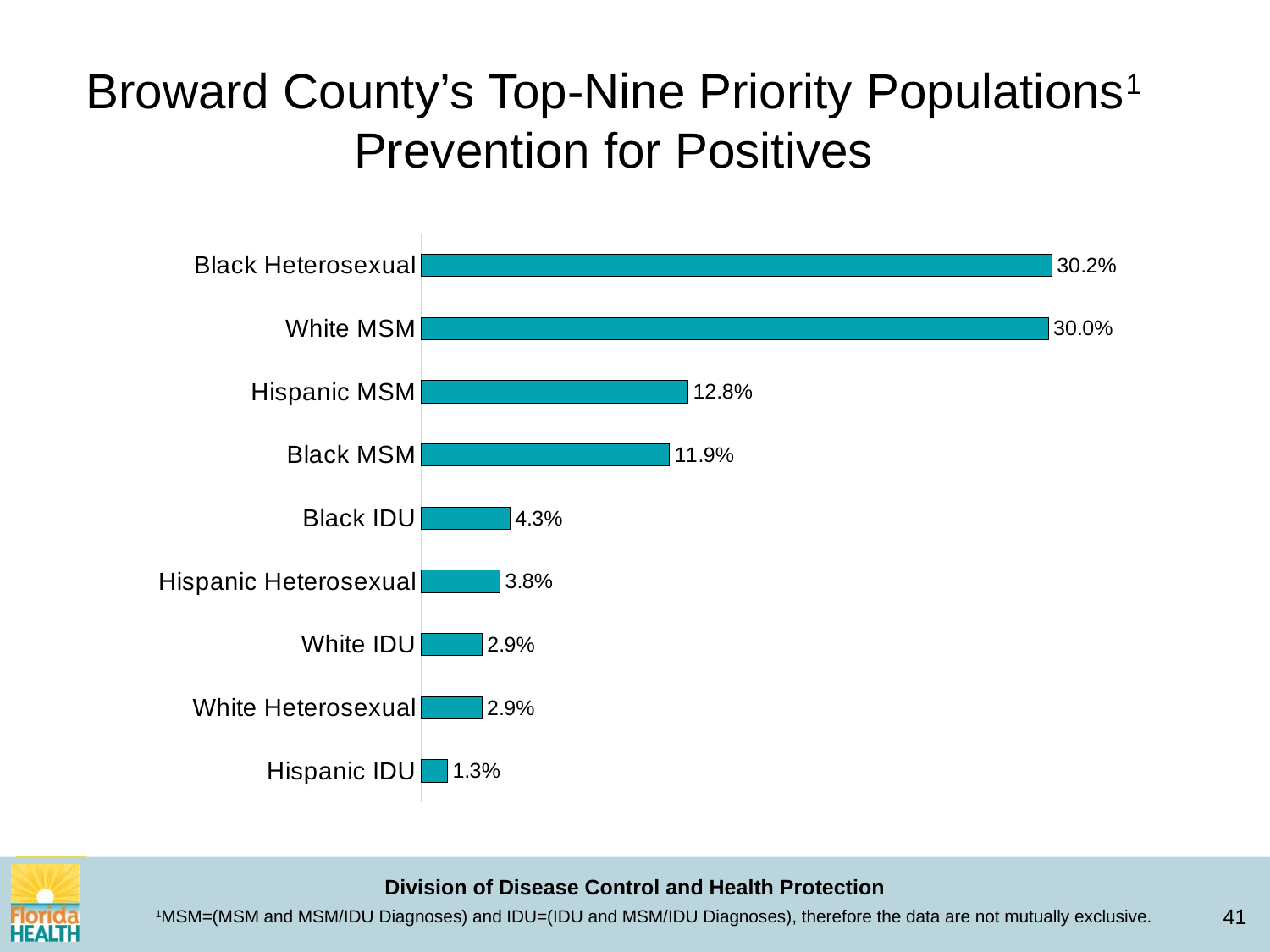
What is the value for Black IDU? 4.3% What is the title of the slide? Broward County's Top-Nine Priority Populations Prevention for Positives Which is larger, the value for Black IDU or the value for Hispanic Heterosexual? Black IDU What is the difference between the values for Black Heterosexual and White MSM? 0.2% What is the value for Black Heterosexual? 30.2% How many categories are shown in the chart? 9 What kind of chart is shown on the slide? Bar chart Which category has the lowest value? Hispanic IDU What is the difference between the values for Hispanic MSM and Black MSM? 0.9% What is the value for Hispanic MSM? 12.8% What is the value for Hispanic IDU? 1.3% Which category has the highest value? Black Heterosexual